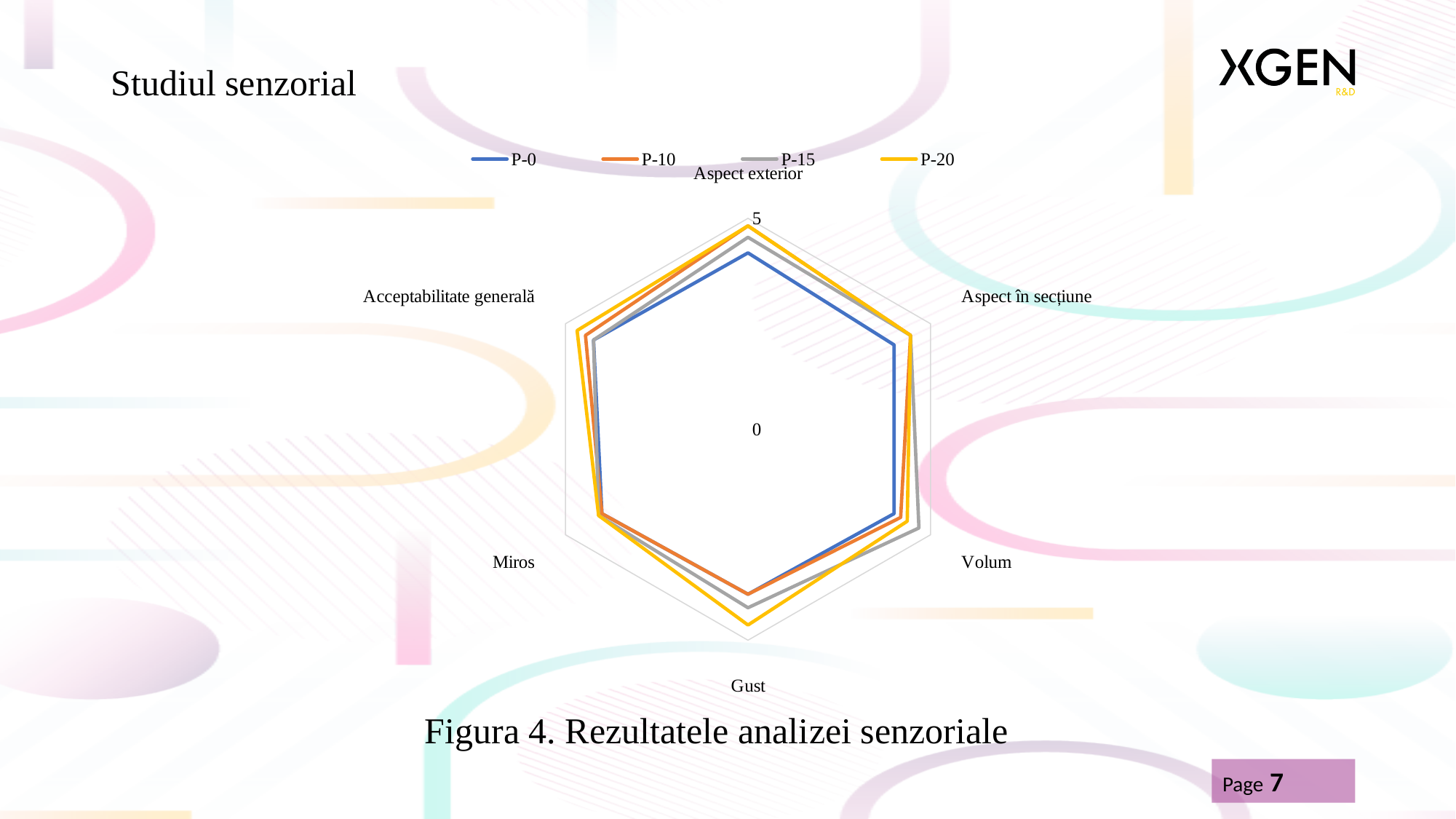
Is the value for P-0 at Aspect exterior greater or less than 5? less Which is larger for Volum: the value for P-15 or the value for P-0? P-15 Which series has the lowest value for Aspect exterior? P-0 Which series has the highest value for Gust? P-20 What are the series names listed in the legend? P-0, P-10, P-15, P-20 What kind of chart is shown on the slide? Radar chart What is the caption given for the chart? Figura 4. Rezultatele analizei senzoriale Which series has the lowest value for Volum? P-0 How many categories (axes) does the radar chart have? 6 Which is larger for Gust: the value for P-20 or the value for P-0? P-20 How many series does the legend list? 4